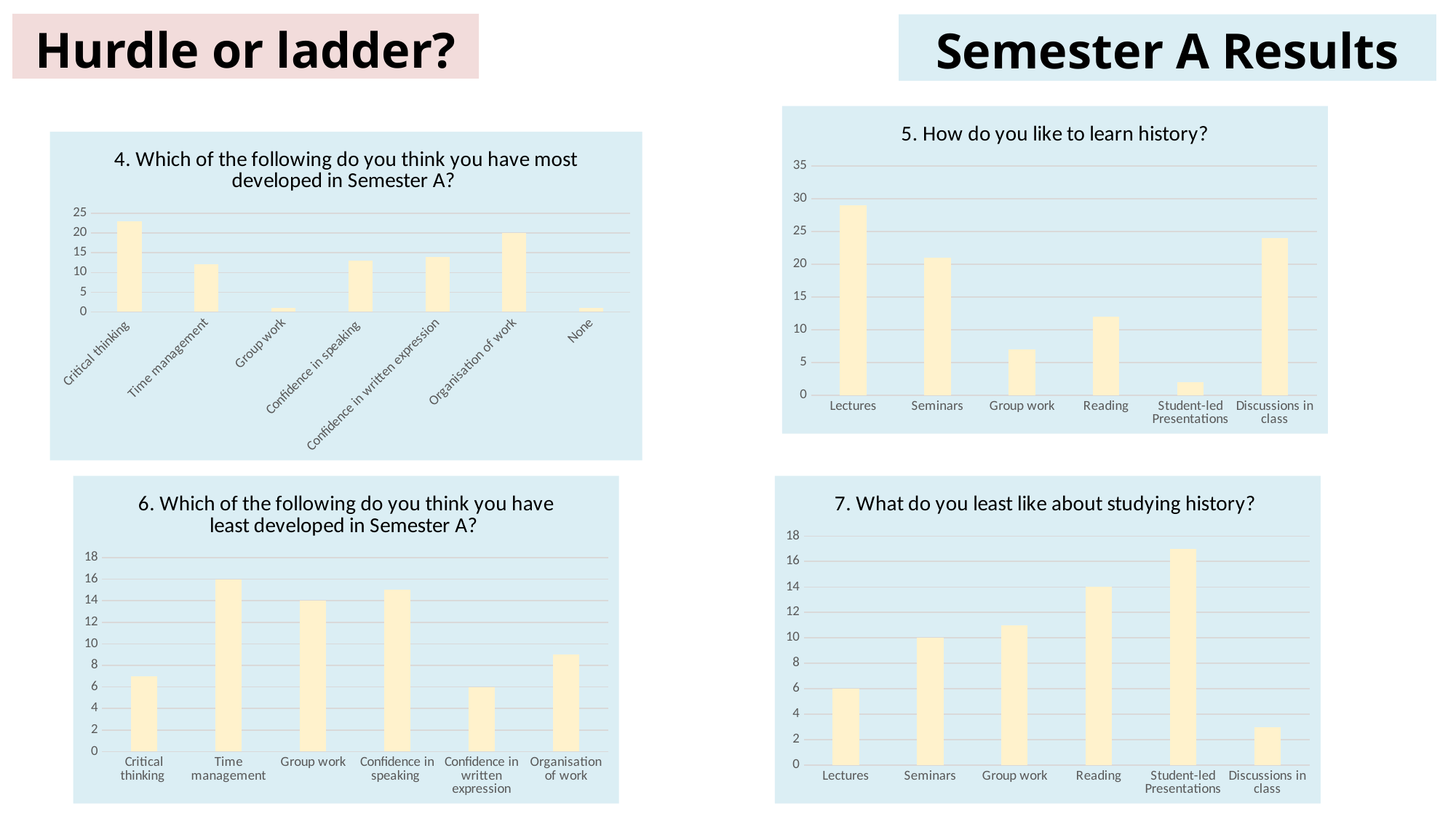
What kind of chart is used for "5. How do you like to learn history?"? bar chart How many categories are shown in the chart "4. Which of the following do you think you have most developed in Semester A?"? 7 In the chart "5. How do you like to learn history?", is the value for Discussions in class greater or less than 20? greater In the chart "7. What do you least like about studying history?", what is the value for Reading? 14 In the chart "7. What do you least like about studying history?", which category has the highest value? Student-led Presentations In the chart "6. Which of the following do you think you have least developed in Semester A?", which category has the highest value? Time management In the chart "4. Which of the following do you think you have most developed in Semester A?", is the value for Time management greater or less than 15? less In the chart "4. Which of the following do you think you have most developed in Semester A?", which category has the highest value? Critical thinking In the chart "6. Which of the following do you think you have least developed in Semester A?", which is larger: Critical thinking or Organisation of work? Organisation of work In the chart "5. How do you like to learn history?", which category has the lowest value? Student-led Presentations In the chart "6. Which of the following do you think you have least developed in Semester A?", what is the value for Group work? 14